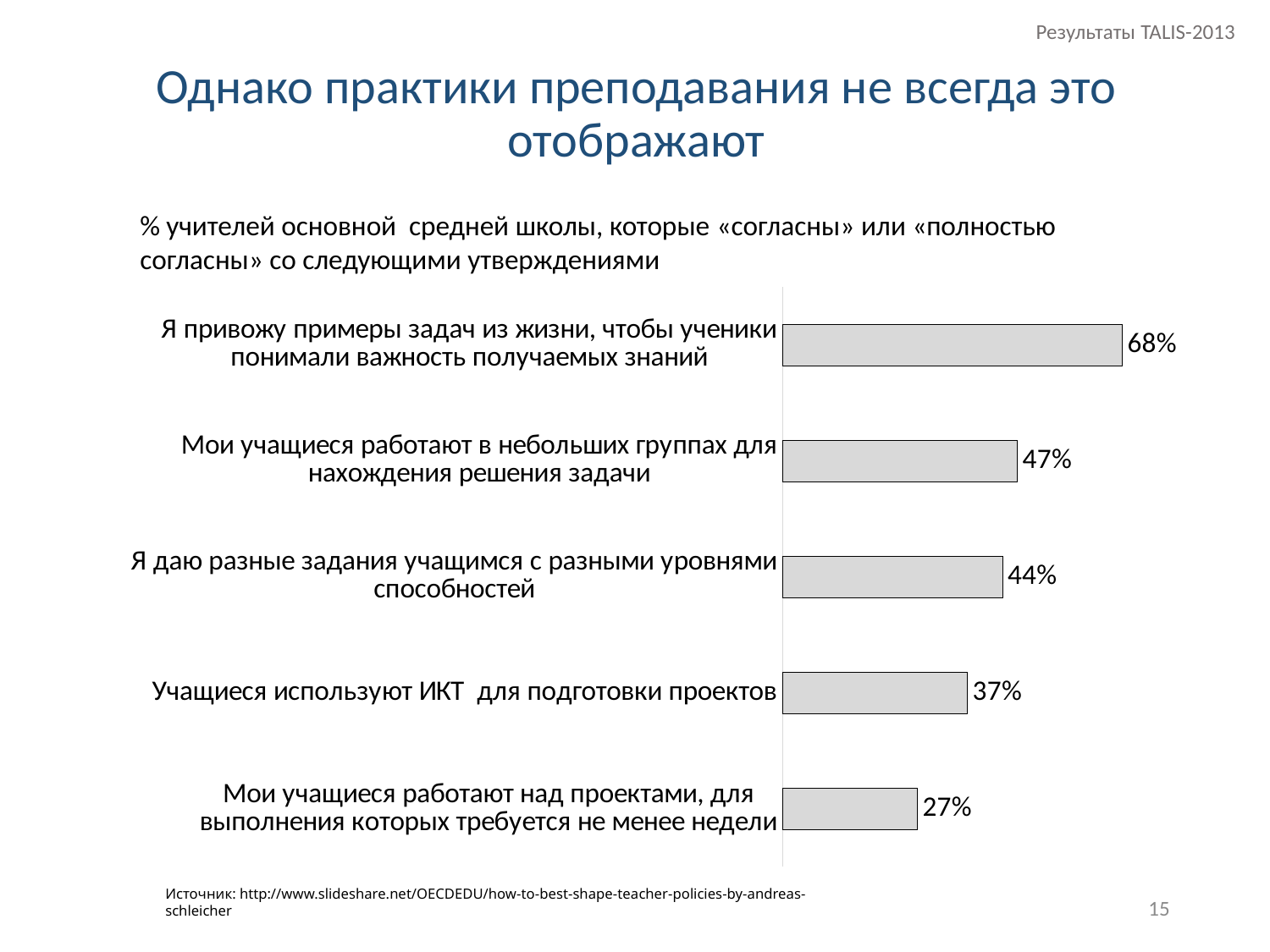
What percentage of teachers agree with the statement "Я привожу примеры задач из жизни, чтобы ученики понимали важность получаемых знаний"? 68% What is the value for "Учащиеся используют ИКТ для подготовки проектов"? 37% What is the title of the slide? Однако практики преподавания не всегда это отображают What is the value for "Мои учащиеся работают в небольших группах для нахождения решения задачи"? 47% Which statement has the lowest percentage of teachers agreeing? Мои учащиеся работают над проектами, для выполнения которых требуется не менее недели Which is larger: the value for "Учащиеся используют ИКТ для подготовки проектов" or the value for "Я даю разные задания учащимся с разными уровнями способностей"? Я даю разные задания учащимся с разными уровнями способностей How many statements (bars) are shown in the chart? 5 What is the difference between the value for "Я привожу примеры задач из жизни..." and the value for "Мои учащиеся работают над проектами..."? 41% What type of chart is shown on the slide? Bar chart What is the value for "Мои учащиеся работают над проектами, для выполнения которых требуется не менее недели"? 27% Which statement has the highest percentage of teachers agreeing? Я привожу примеры задач из жизни, чтобы ученики понимали важность получаемых знаний What is the difference between the values for "Мои учащиеся работают в небольших группах..." and "Я даю разные задания учащимся с разными уровнями способностей"? 3%